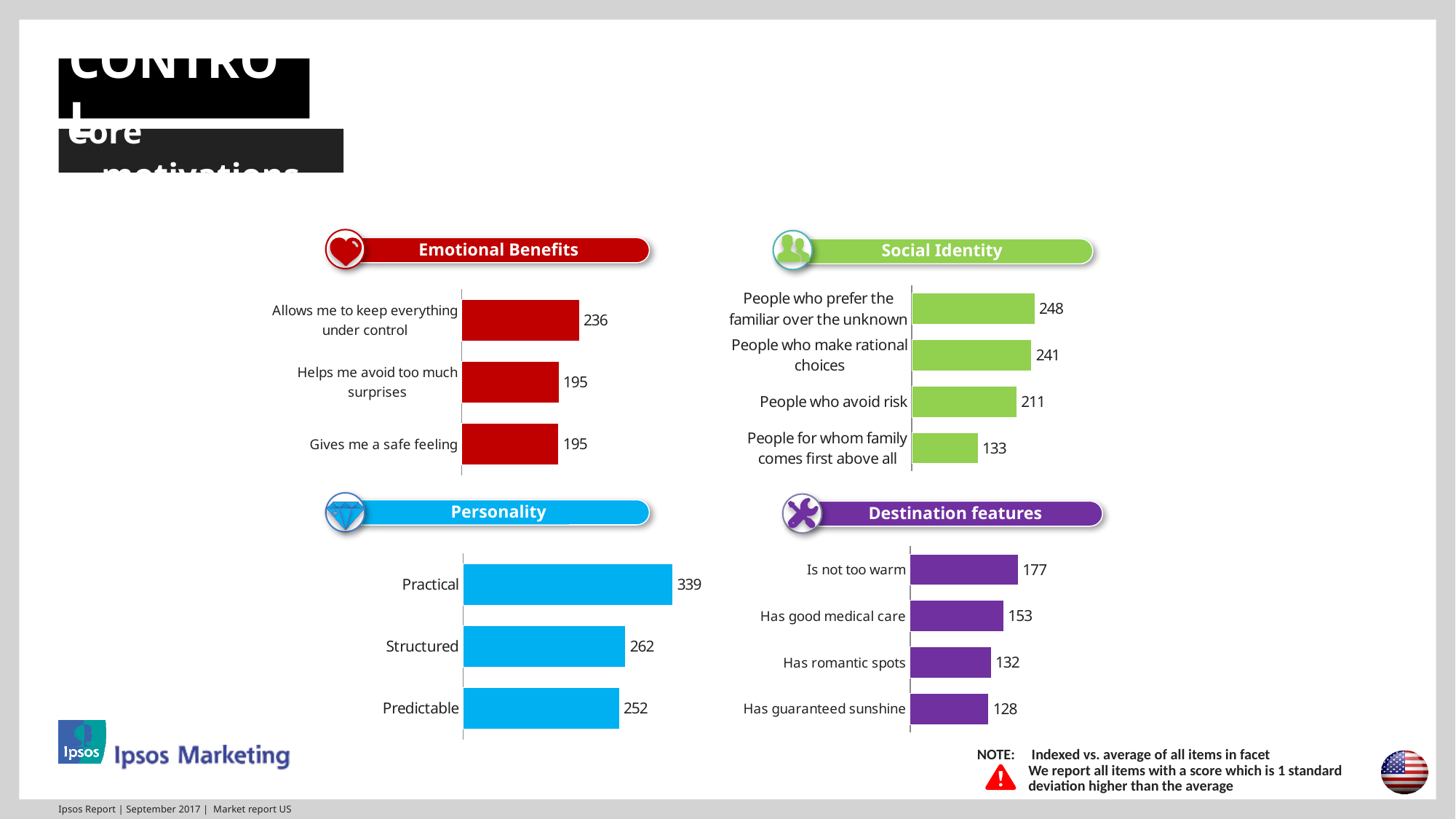
In the Social Identity chart, which category has the lowest value? People for whom family comes first above all In the Social Identity chart, what is the value for "People who avoid risk"? 211 In the Personality chart, which category has the highest value? Practical In the Destination features chart, which is larger: "Is not too warm" or "Has guaranteed sunshine"? Is not too warm In the Social Identity chart, what is the difference between "People who prefer the familiar over the unknown" and "People who make rational choices"? 7 What kind of chart is the Personality chart? Bar chart How many categories does the Social Identity chart show? 4 What colour are the bars in the Destination features chart? Purple In the Destination features chart, what is the value for "Has good medical care"? 153 How many categories does the Emotional Benefits chart show? 3 In the Personality chart, what is the difference between the values for Practical and Structured? 77 In the Emotional Benefits chart, what is the value for "Allows me to keep everything under control"? 236